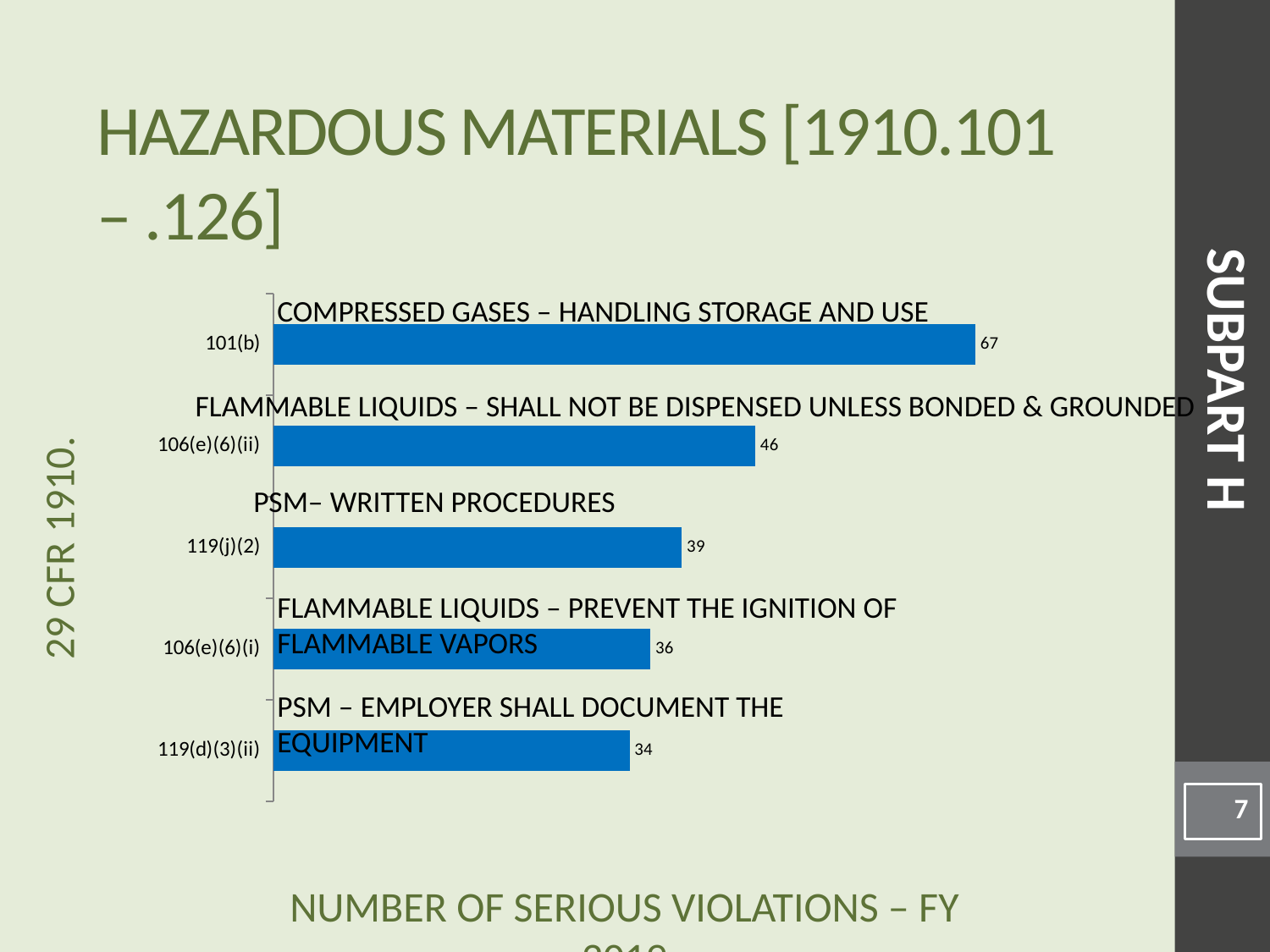
Which category has the highest number of serious violations? 101(b) What is the number of serious violations for 106(e)(6)(ii)? 46 How many categories are shown in the chart? 5 What is the difference between the values for 101(b) and 106(e)(6)(ii)? 21 What is the text label shown above the bar for 119(j)(2)? PSM– WRITTEN PROCEDURES What is the number of serious violations for 119(j)(2)? 39 What is the number of serious violations for 101(b)? 67 What is the difference between the values for 106(e)(6)(i) and 119(d)(3)(ii)? 2 Which category has the lowest number of serious violations? 119(d)(3)(ii) What kind of chart is shown on the slide? Bar chart What is the number of serious violations for 119(d)(3)(ii)? 34 Which has more serious violations, 119(j)(2) or 106(e)(6)(i)? 119(j)(2)